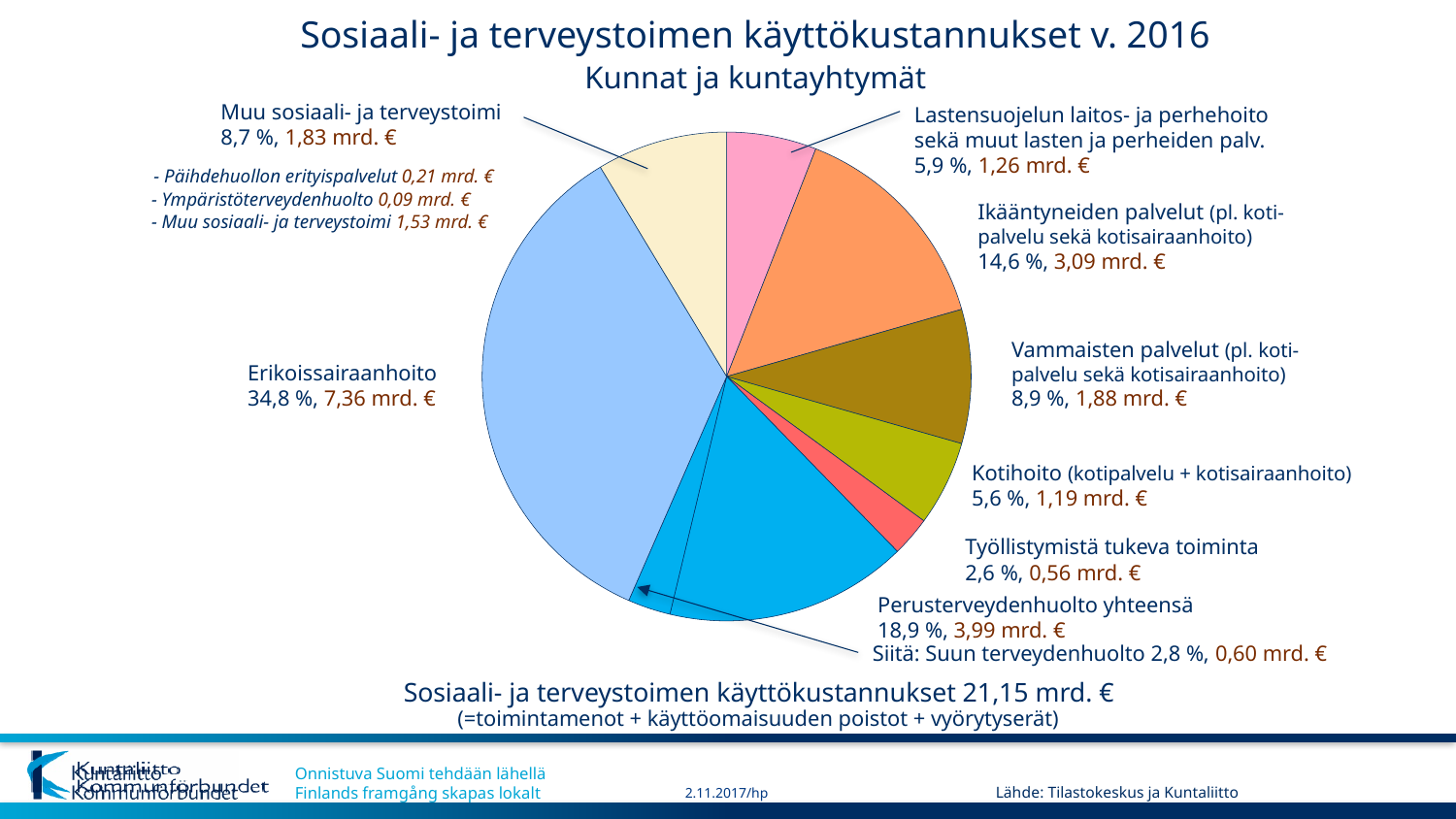
What total for Sosiaali- ja terveystoimen käyttökustannukset is stated below the chart? 21,15 mrd. € What is the value in mrd. € for Perusterveydenhuolto yhteensä? 3,99 mrd. € What is the value in mrd. € for Ikääntyneiden palvelut? 3,09 mrd. € Which category has the largest slice of the pie? Erikoissairaanhoito What share of the pie does Erikoissairaanhoito represent? 34,8 % What percentage share is shown for Kotihoito? 5,6 % What year does the chart title refer to? 2016 What is the value in mrd. € for Suun terveydenhuolto? 0,60 mrd. € What is the difference in mrd. € between Erikoissairaanhoito and Perusterveydenhuolto yhteensä? 3,37 mrd. € Which is larger, Vammaisten palvelut or Muu sosiaali- ja terveystoimi? Vammaisten palvelut Which labelled category has the smallest share of the pie? Työllistymistä tukeva toiminta What kind of chart is shown on the slide? pie chart